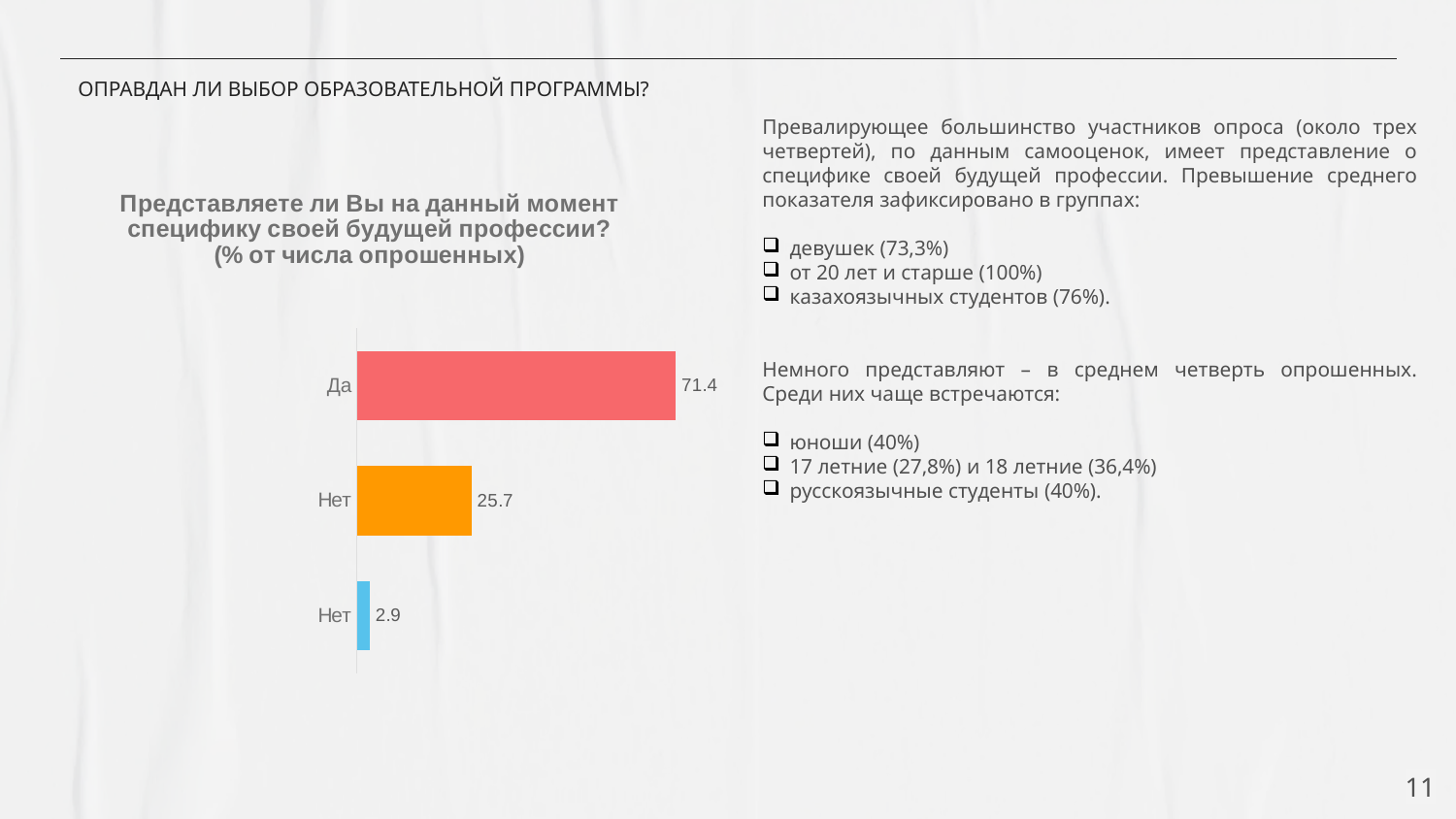
How many bars are plotted in the chart? 3 What value is shown for "Да" in the chart? 71.4 Which is larger: the value for "Да" or the value of the middle bar? Да Which category has the highest value in the chart? Да What is the difference between the value for "Да" and the value of the middle bar (25.7)? 45.7 What value is shown for the middle (orange) bar in the chart? 25.7 What type of chart is shown on the slide? Bar chart What value is shown for the bottom (blue) bar in the chart? 2.9 What is the title of the chart? Представляете ли Вы на данный момент специфику своей будущей профессии? (% от числа опрошенных) What is the difference between the middle bar (25.7) and the bottom bar (2.9)? 22.8 What is the smallest value shown in the chart? 2.9 What colour is the bar for "Да"? Red